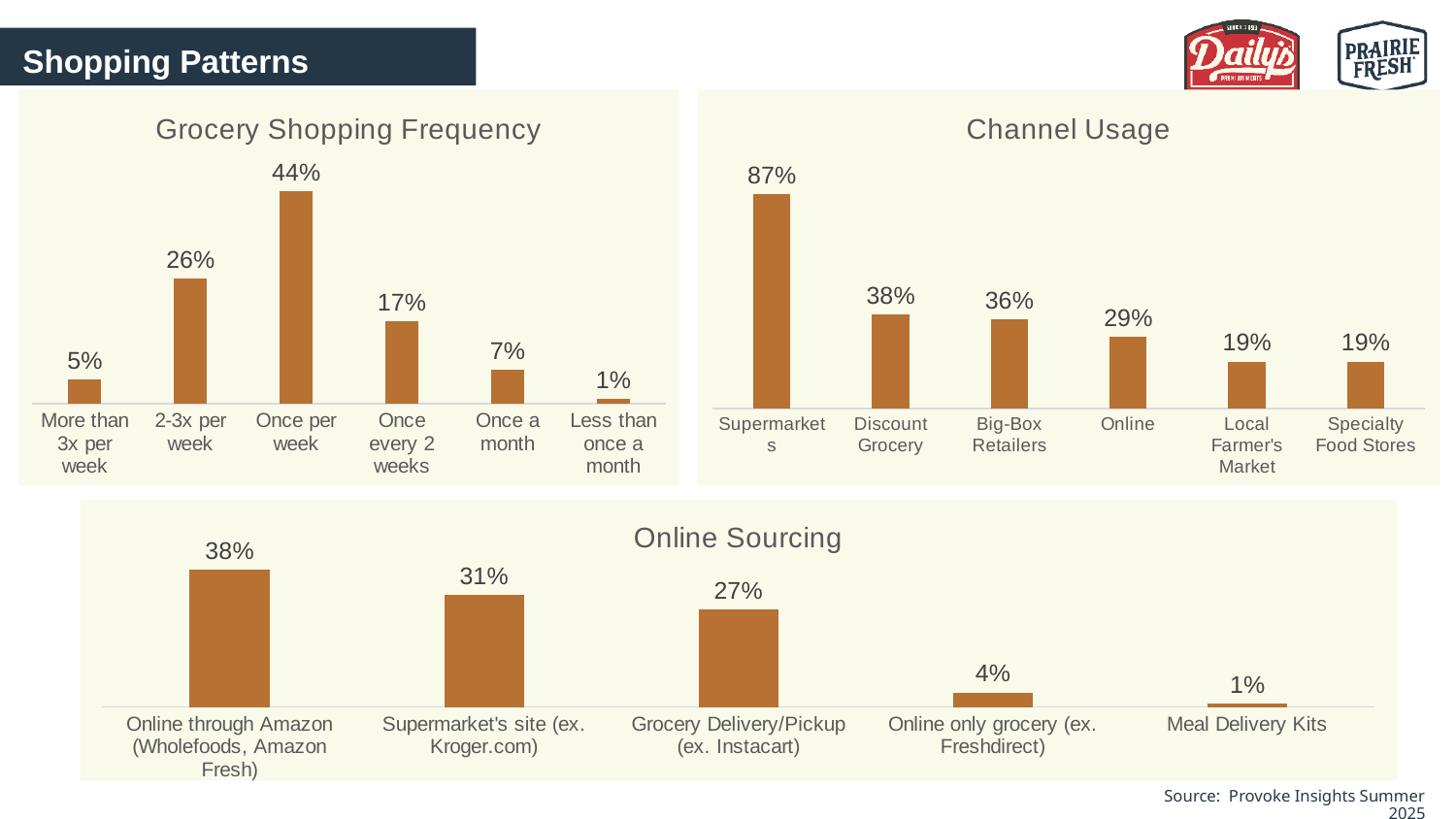
In the Channel Usage chart, which is larger: Discount Grocery or Big-Box Retailers? Discount Grocery In the Grocery Shopping Frequency chart, what is the difference between the values for 2-3x per week and Once every 2 weeks? 9% In the Channel Usage chart, what is the difference between Supermarkets and Online? 58% In the Online Sourcing chart, how many categories are shown? 5 In the Online Sourcing chart, which category has the highest value? Online through Amazon (Wholefoods, Amazon Fresh) In the Channel Usage chart, what is the value for Local Farmer's Market? 19% In the Channel Usage chart, what is the value for Supermarkets? 87% What type of chart is the Online Sourcing chart? Bar chart In the Grocery Shopping Frequency chart, what percentage of respondents shop once per week? 44% In the Online Sourcing chart, what is the value for Grocery Delivery/Pickup (ex. Instacart)? 27% In the Grocery Shopping Frequency chart, how many categories are shown? 6 In the Grocery Shopping Frequency chart, which category has the lowest value? Less than once a month